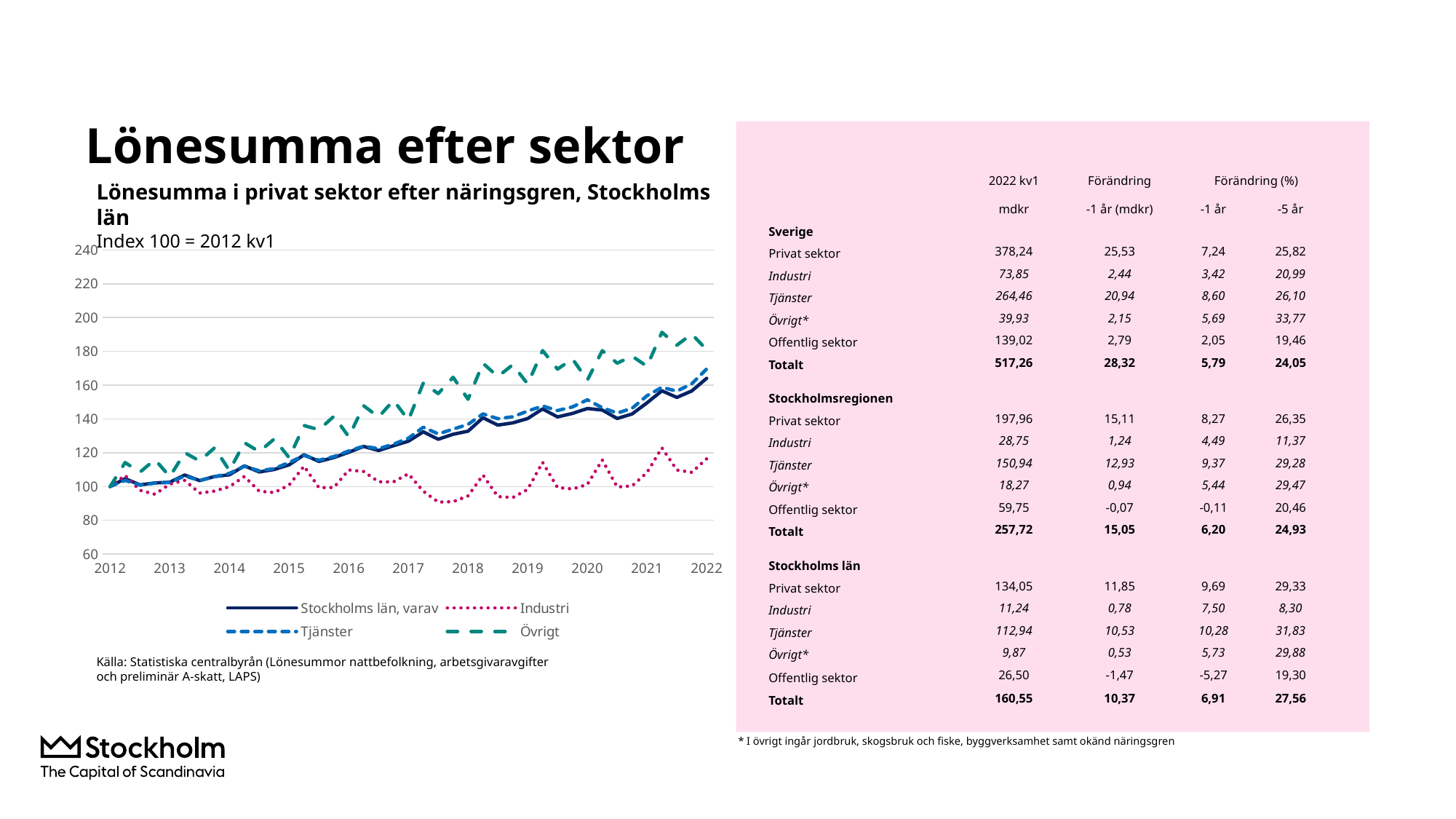
Which series has the lowest value at the end of the chart in 2022? Industri Is the value for Övrigt in 2022 greater or less than 160? greater Does the Övrigt series generally rise or fall from 2012 to 2022? rise How many year labels are shown on the x axis? 11 In 2020, which is larger: the value for Tjänster or the value for Industri? Tjänster How many series does the chart legend list? 4 What kind of chart is shown on the slide? line chart What is the title of the chart? Lönesumma i privat sektor efter näringsgren, Stockholms län What base period is the index set to 100 in the chart? 2012 kv1 Which series has the highest value at the end of the chart in 2022? Övrigt Is the value for Stockholms län, varav in 2022 greater or less than 140? greater Is the value for Industri in 2022 greater or less than 140? less